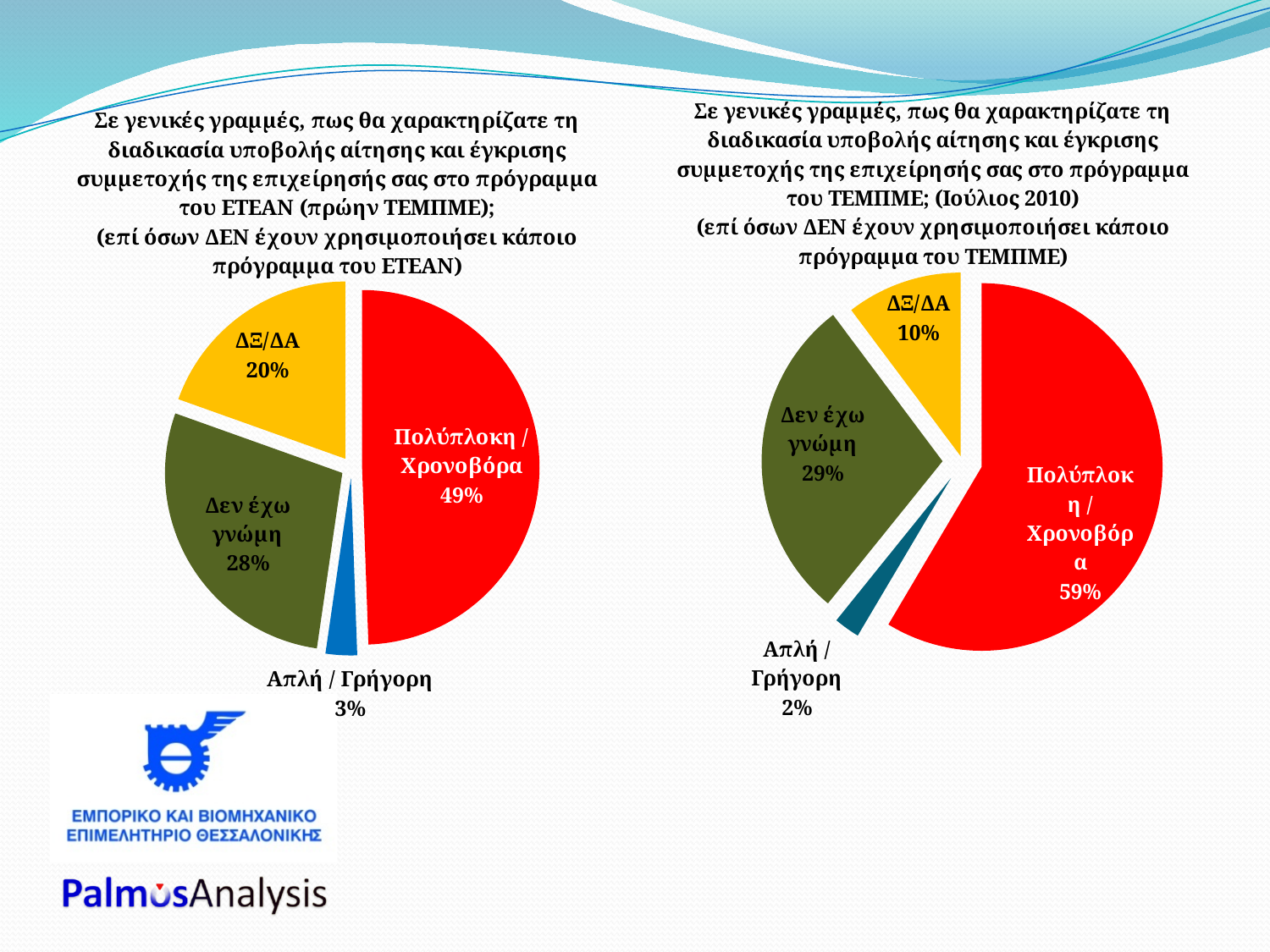
How many slices does the right pie chart (ΤΕΜΠΜΕ, Ιούλιος 2010) have? 4 In the left pie chart (ETEAN), what colour is the 'Δεν έχω γνώμη' slice? Green In the right pie chart (ΤΕΜΠΜΕ, Ιούλιος 2010), which category has the smallest slice? Απλή / Γρήγορη What is the difference between the 'Πολύπλοκη / Χρονοβόρα' share in the right pie chart and the same share in the left pie chart? 10 percentage points What type of chart is used on the left side of the slide? Pie chart Which is larger: the 'ΔΞ/ΔΑ' share in the left pie chart or in the right pie chart? Left pie chart In the right pie chart (ΤΕΜΠΜΕ, Ιούλιος 2010), what share is labelled 'ΔΞ/ΔΑ'? 10% In the left pie chart (ETEAN), what share is labelled 'Πολύπλοκη / Χρονοβόρα'? 49% In the right pie chart (ΤΕΜΠΜΕ, Ιούλιος 2010), what share is labelled 'Δεν έχω γνώμη'? 29% In the left pie chart (ETEAN), what is the difference between the 'Δεν έχω γνώμη' share and the 'ΔΞ/ΔΑ' share? 8 percentage points In the left pie chart (ETEAN), which category has the largest slice? Πολύπλοκη / Χρονοβόρα In the left pie chart (ETEAN), what share is labelled 'Απλή / Γρήγορη'? 3%